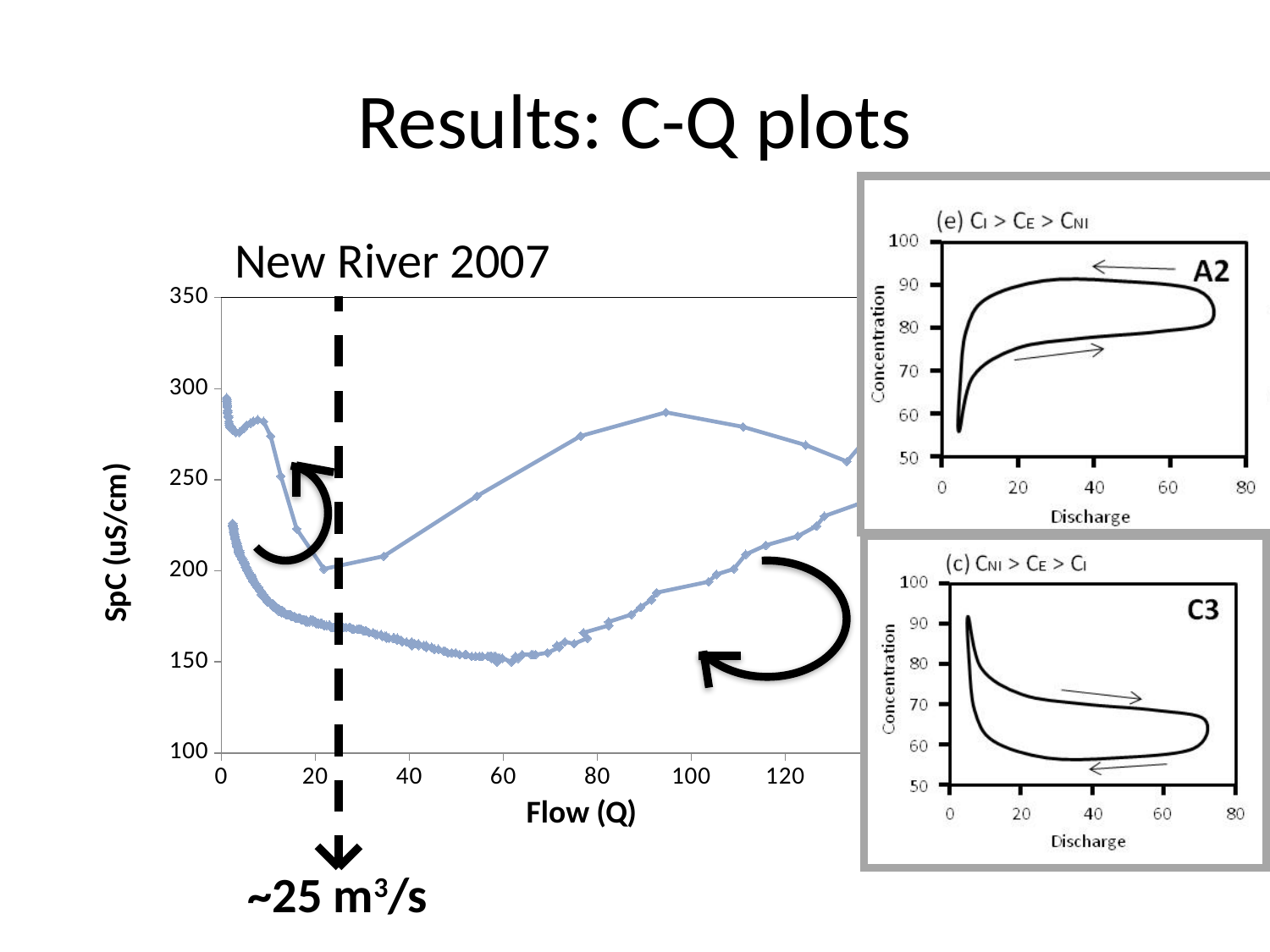
What kind of chart is the New River 2007 chart? line chart In the A2 inset chart, is the concentration on the upper limb of the loop at a discharge of 40 greater or less than 80? greater How many inset reference diagrams are shown on the right side of the slide? 2 In the C3 inset chart, is the peak concentration at low discharge greater or less than 80? greater What is the y-axis title of the New River 2007 chart? SpC (uS/cm) In the New River 2007 chart, does SpC on the lower curve rise or fall as flow increases from 0 to 60? fall In the New River 2007 chart, is the SpC value at the lowest flow on the upper curve greater or less than 250? greater What flow value does the dashed vertical line on the New River 2007 chart mark? ~25 m³/s In the New River 2007 chart, at a flow of 100, which curve has the higher SpC, the upper or the lower one? upper